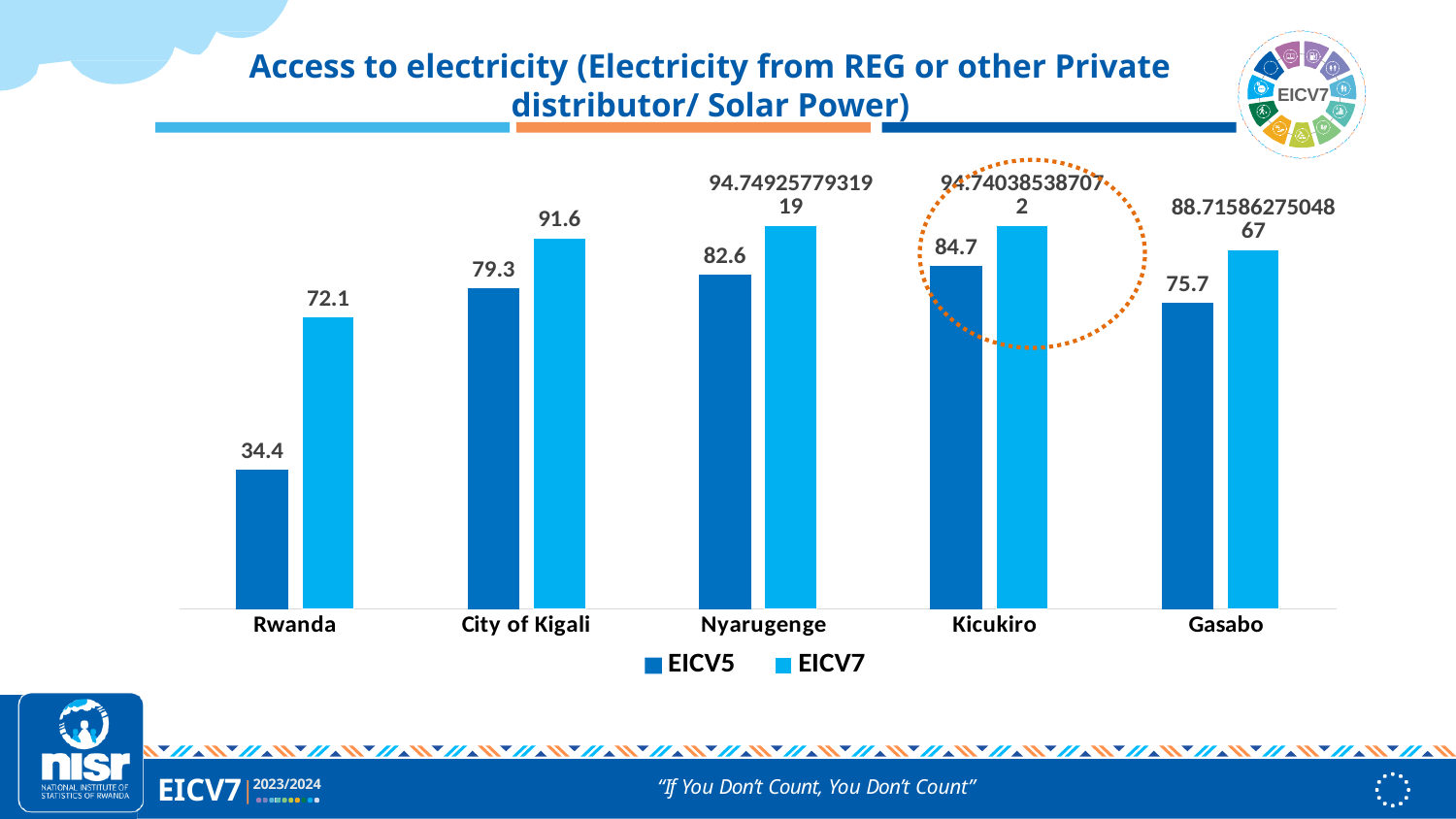
Which category has the highest EICV5 value? Kicukiro What is the EICV7 value for City of Kigali? 91.6 How many series does the legend list? 2 What is the EICV5 value for Kicukiro? 84.7 How many categories are shown on the x axis? 5 What is the EICV5 value for Gasabo? 75.7 What is the difference between the EICV7 and EICV5 values for City of Kigali? 12.3 Which category has the lowest EICV5 value? Rwanda What is the EICV5 value for Rwanda? 34.4 Which is larger, the EICV5 value for Nyarugenge or the EICV5 value for Gasabo? Nyarugenge Which category has the lowest EICV7 value? Rwanda What is the difference between the EICV7 and EICV5 values for Rwanda? 37.7